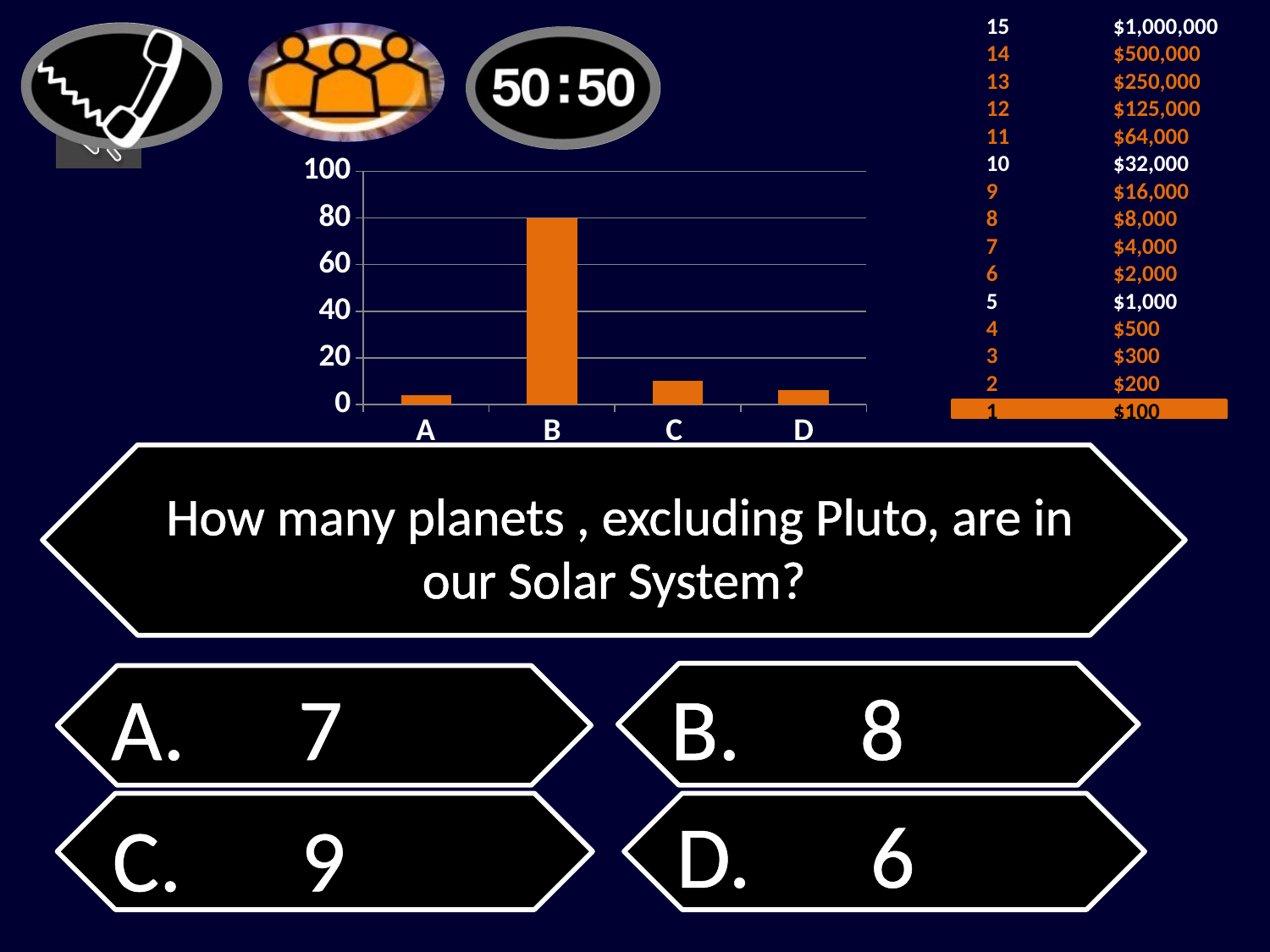
Is the value for A greater or less than 20? less How many categories are shown on the x axis of the chart? 4 What is the highest value shown on the chart's vertical axis? 100 What colour are the bars in the chart? orange Is the value for B greater or less than 60? greater Which category has the highest bar in the chart? B Which is larger, the value for B or the value for C? B What kind of chart is shown on the slide? bar chart Which is larger, the value for C or the value for A? C Is the value for D greater or less than 20? less What is the value for category B in the chart? 80